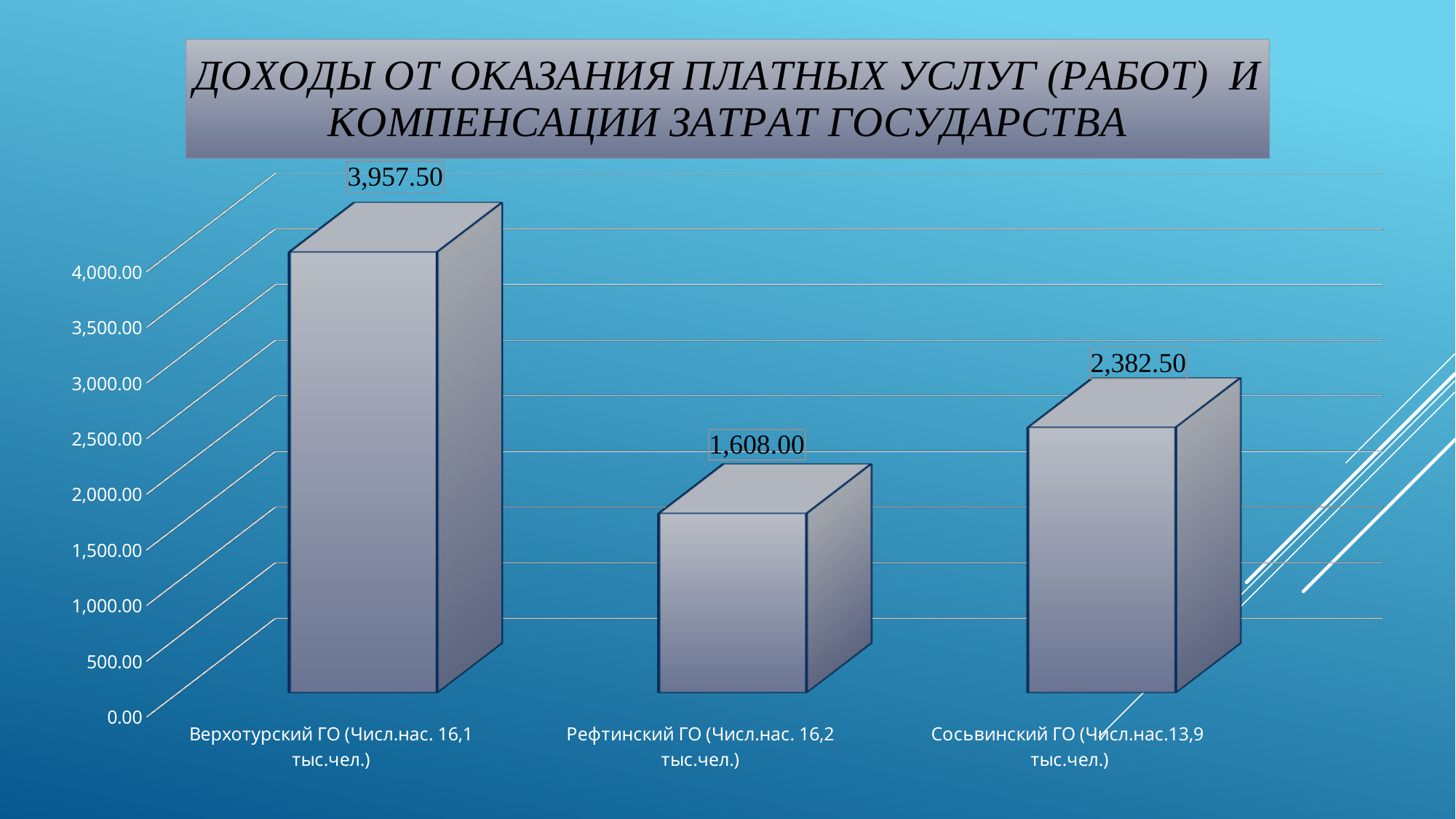
Is the value for Сосьвинский ГО greater or less than 2,000.00? greater What is the value for Сосьвинский ГО? 2,382.50 What is the difference between the values for Верхотурский ГО and Рефтинский ГО? 2,349.50 What is the title of the chart? ДОХОДЫ ОТ ОКАЗАНИЯ ПЛАТНЫХ УСЛУГ (РАБОТ) И КОМПЕНСАЦИИ ЗАТРАТ ГОСУДАРСТВА What is the value for Рефтинский ГО? 1,608.00 Which is larger, the value for Сосьвинский ГО or the value for Рефтинский ГО? Сосьвинский ГО What kind of chart is shown on the slide? bar chart Which category has the highest value? Верхотурский ГО What is the value for Верхотурский ГО? 3,957.50 How many categories are shown on the chart? 3 Which category has the lowest value? Рефтинский ГО What is the difference between the values for Сосьвинский ГО and Рефтинский ГО? 774.50